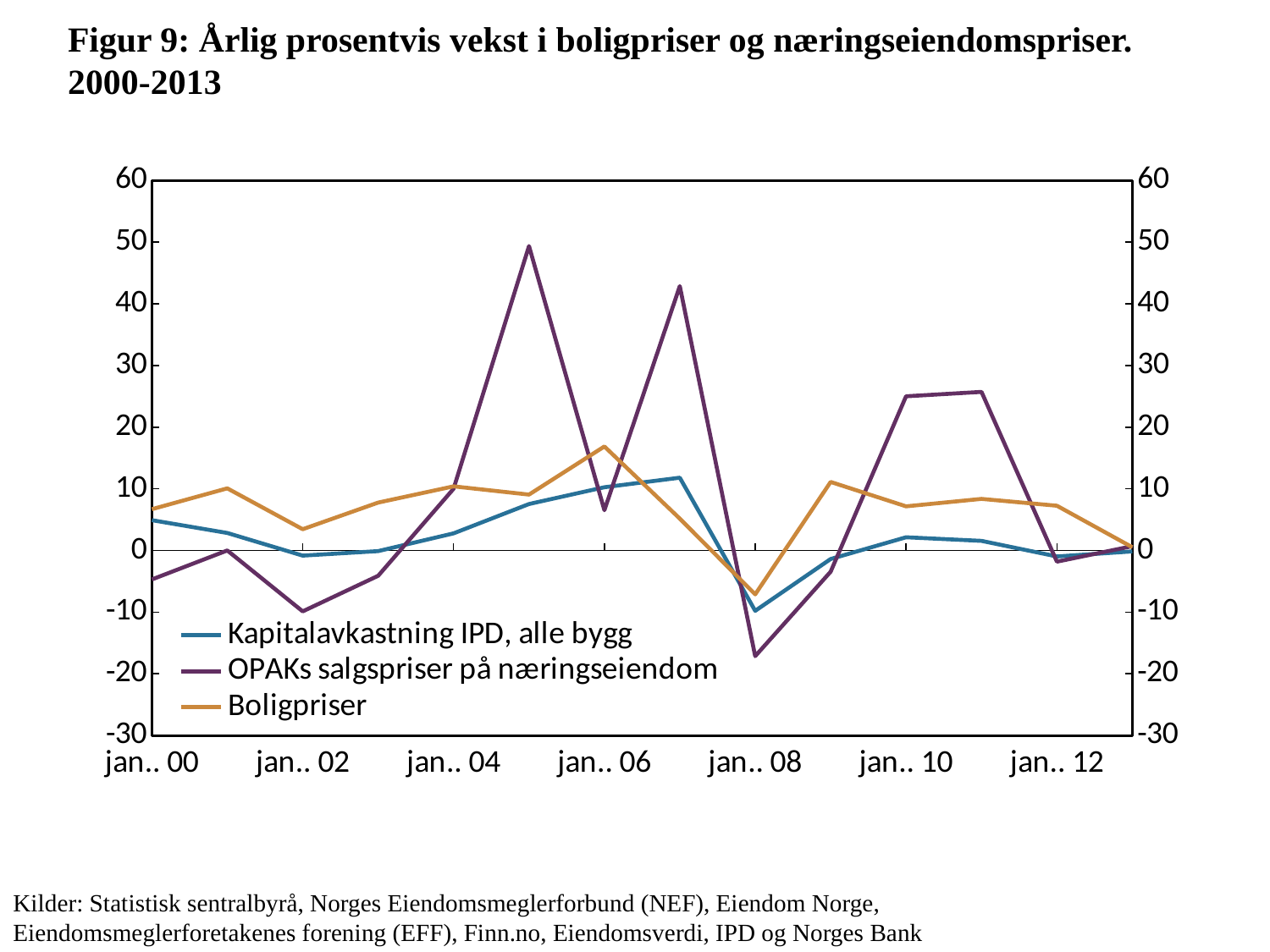
Is the value of OPAKs salgspriser på næringseiendom at jan.. 10 greater or less than 20? greater Does the Boligpriser series rise or fall between jan.. 10 and the end of the chart? fall How many series does the legend list? 3 Is the value of Boligpriser at jan.. 06 greater or less than 10? greater What kind of chart is shown on the slide? line chart At jan.. 05, which is larger: OPAKs salgspriser på næringseiendom or Boligpriser? OPAKs salgspriser på næringseiendom Is the peak value of OPAKs salgspriser på næringseiendom around jan.. 05 greater or less than 40? greater Which series reaches the highest value anywhere on the chart? OPAKs salgspriser på næringseiendom Which series is drawn in purple according to the legend? OPAKs salgspriser på næringseiendom Which series reaches the lowest value anywhere on the chart? OPAKs salgspriser på næringseiendom What is the title of the chart? Figur 9: Årlig prosentvis vekst i boligpriser og næringseiendomspriser. 2000-2013